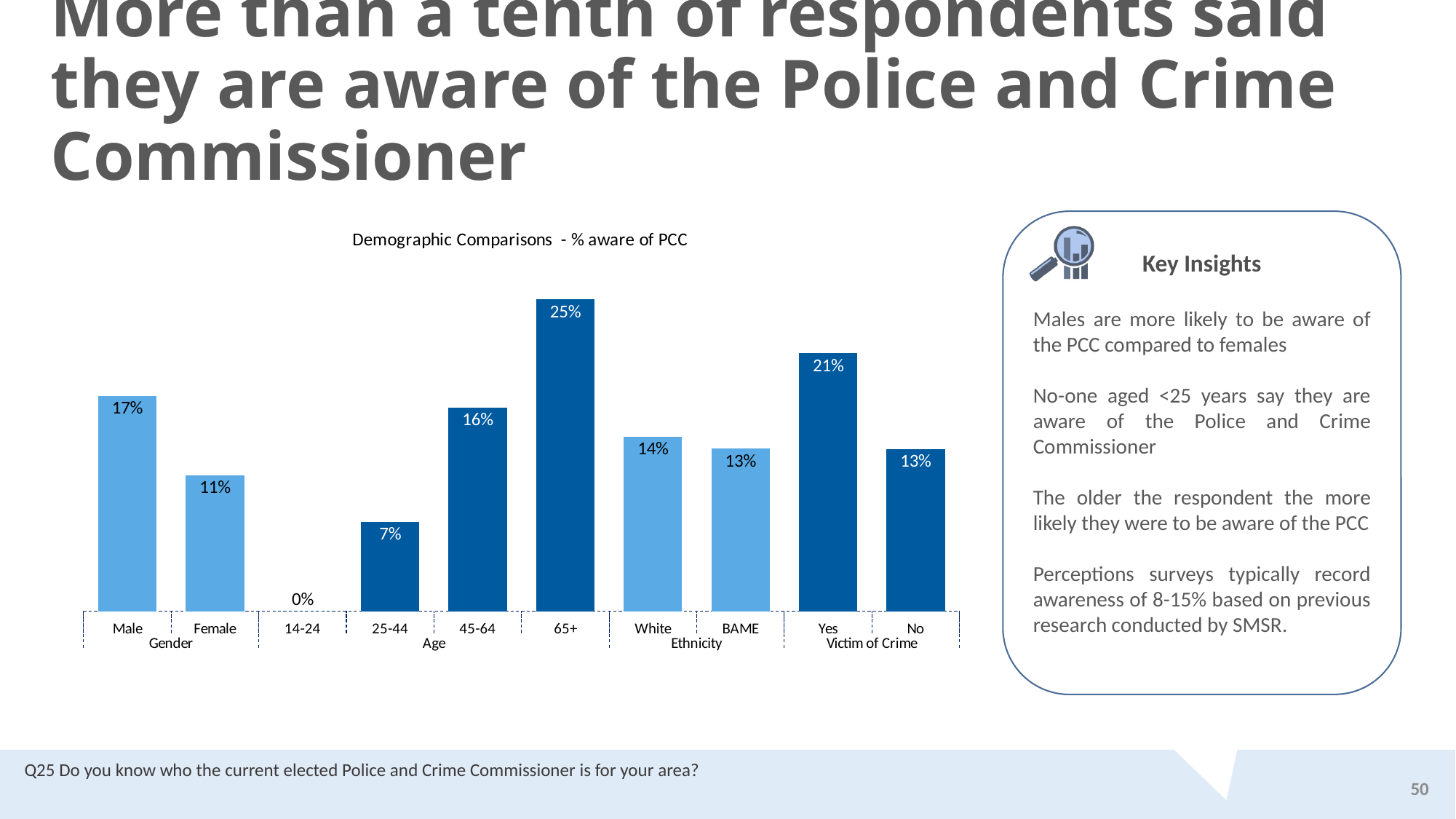
What percentage of male respondents are aware of the PCC? 17% What is the difference between the Male and Female values? 6% Which is larger, the value for White or the value for BAME? White What is the title of the chart? Demographic Comparisons - % aware of PCC Which category has the lowest percentage aware of the PCC? 14-24 What type of chart is shown on the slide? Bar chart Which category has the highest percentage aware of the PCC? 65+ What percentage of BAME respondents are aware of the PCC? 13% What is the difference between the Yes and No values under Victim of Crime? 8% What is the value for respondents aged 14-24? 0% How many categories are plotted in the chart? 10 What is the value for the 65+ age group? 25%